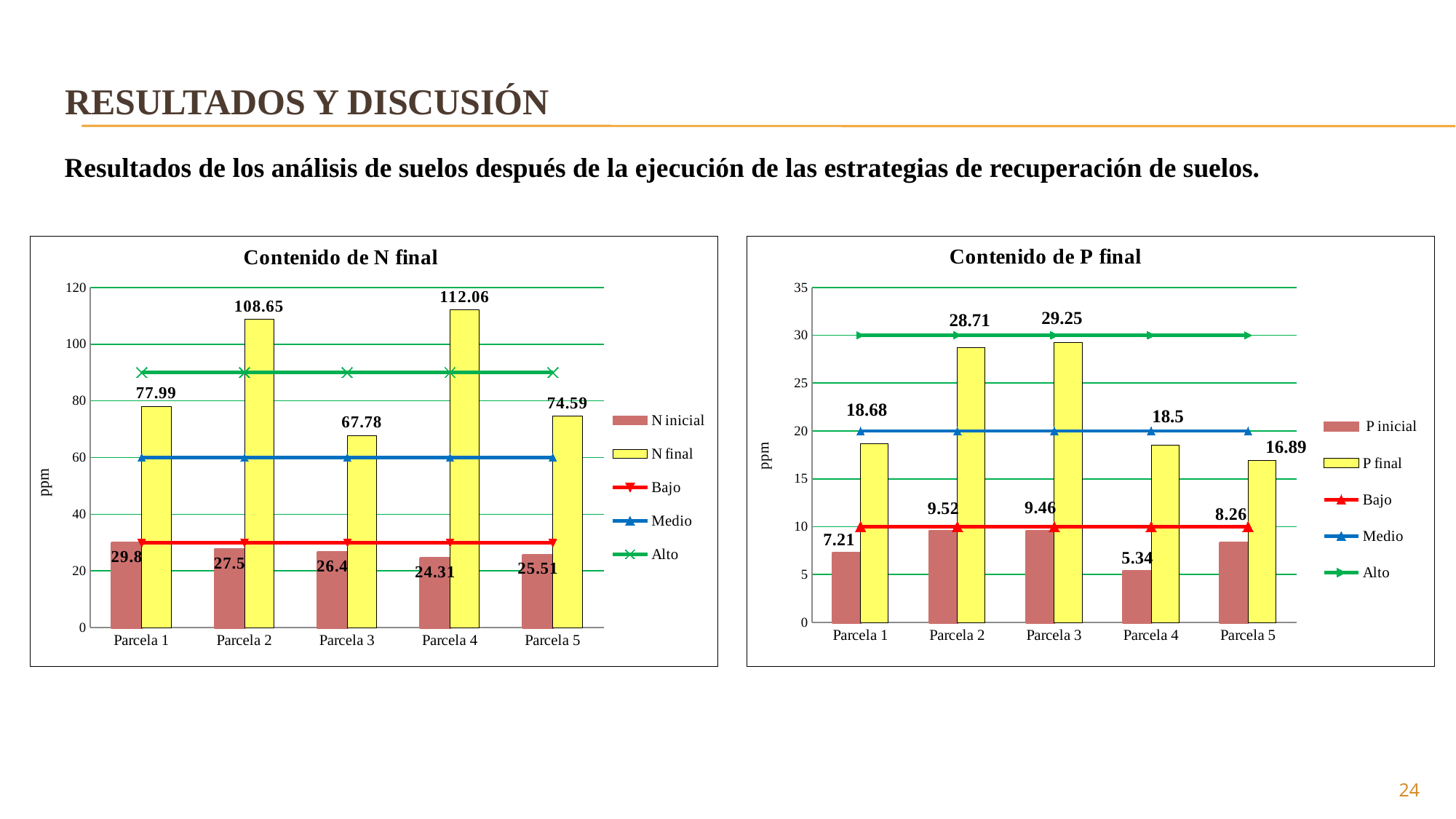
In the 'Contenido de N final' chart, how many series does the legend list? 5 In the 'Contenido de N final' chart, what is the N inicial value for Parcela 1? 29.8 In the 'Contenido de P final' chart, what is the P final value for Parcela 3? 29.25 In the 'Contenido de N final' chart, what is the difference between the N final and N inicial values for Parcela 2? 81.15 In the 'Contenido de N final' chart, is the N final value for Parcela 1 greater or less than 80? less What is the y-axis label of the 'Contenido de P final' chart? ppm In the 'Contenido de N final' chart, what is the N final value for Parcela 4? 112.06 In the 'Contenido de P final' chart, what is the difference between the P final values for Parcela 3 and Parcela 2? 0.54 In the 'Contenido de P final' chart, which parcela has the lowest P inicial value? Parcela 4 In the 'Contenido de P final' chart, which is larger: the P final value for Parcela 1 or for Parcela 5? Parcela 1 In the 'Contenido de P final' chart, how many parcelas are shown on the x axis? 5 In the 'Contenido de N final' chart, which parcela has the lowest N final value? Parcela 3